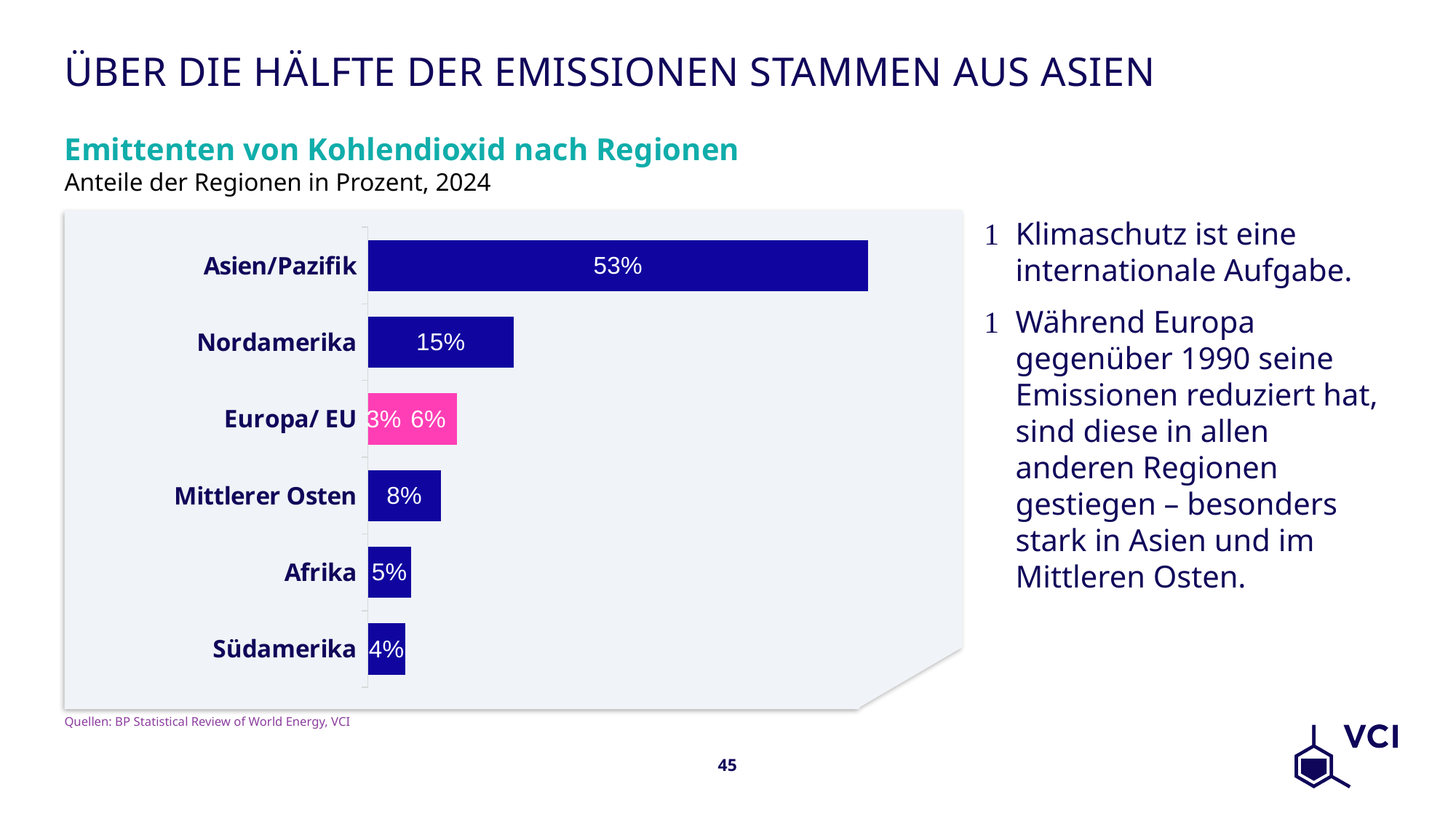
Which has the larger share, Mittlerer Osten or Afrika? Mittlerer Osten What kind of chart is shown on the slide? Bar chart Which region has the lowest share of emissions in the chart? Südamerika Which region has the highest share of emissions in the chart? Asien/Pazifik What share is shown for Mittlerer Osten? 8% What share of carbon dioxide emissions does the chart show for Asien/Pazifik? 53% What is the value for Afrika in the chart? 5% How many percentage points higher is the share of Asien/Pazifik than that of Nordamerika? 38 percentage points What share is shown for Südamerika? 4% What is the value shown for Nordamerika? 15% How many regions are shown in the chart? 6 What is the difference between the shares of Nordamerika and Mittlerer Osten? 7 percentage points